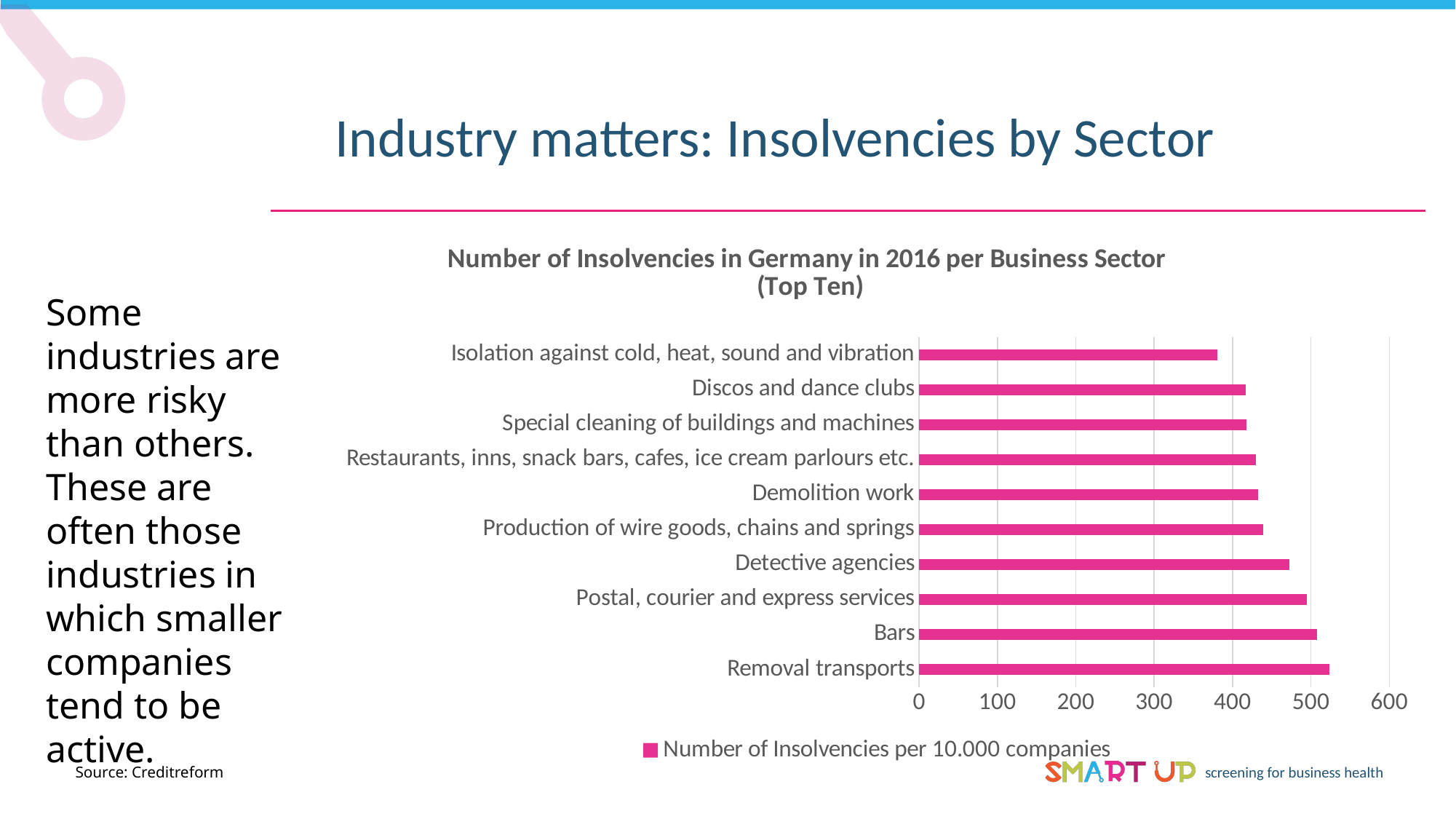
How many business sectors are plotted in the chart? 10 Which has more insolvencies per 10.000 companies: Detective agencies or Discos and dance clubs? Detective agencies Which business sector has the lowest number of insolvencies per 10.000 companies? Isolation against cold, heat, sound and vibration What is the title of the chart? Number of Insolvencies in Germany in 2016 per Business Sector (Top Ten) What series name is shown in the chart legend? Number of Insolvencies per 10.000 companies Is the value for Removal transports greater or less than 500? greater Is the value for Isolation against cold, heat, sound and vibration greater or less than 400? less Is the value for Demolition work greater or less than 500? less Which business sector has the highest number of insolvencies per 10.000 companies? Removal transports What kind of chart is shown on the slide? Bar chart How many series does the chart legend list? 1